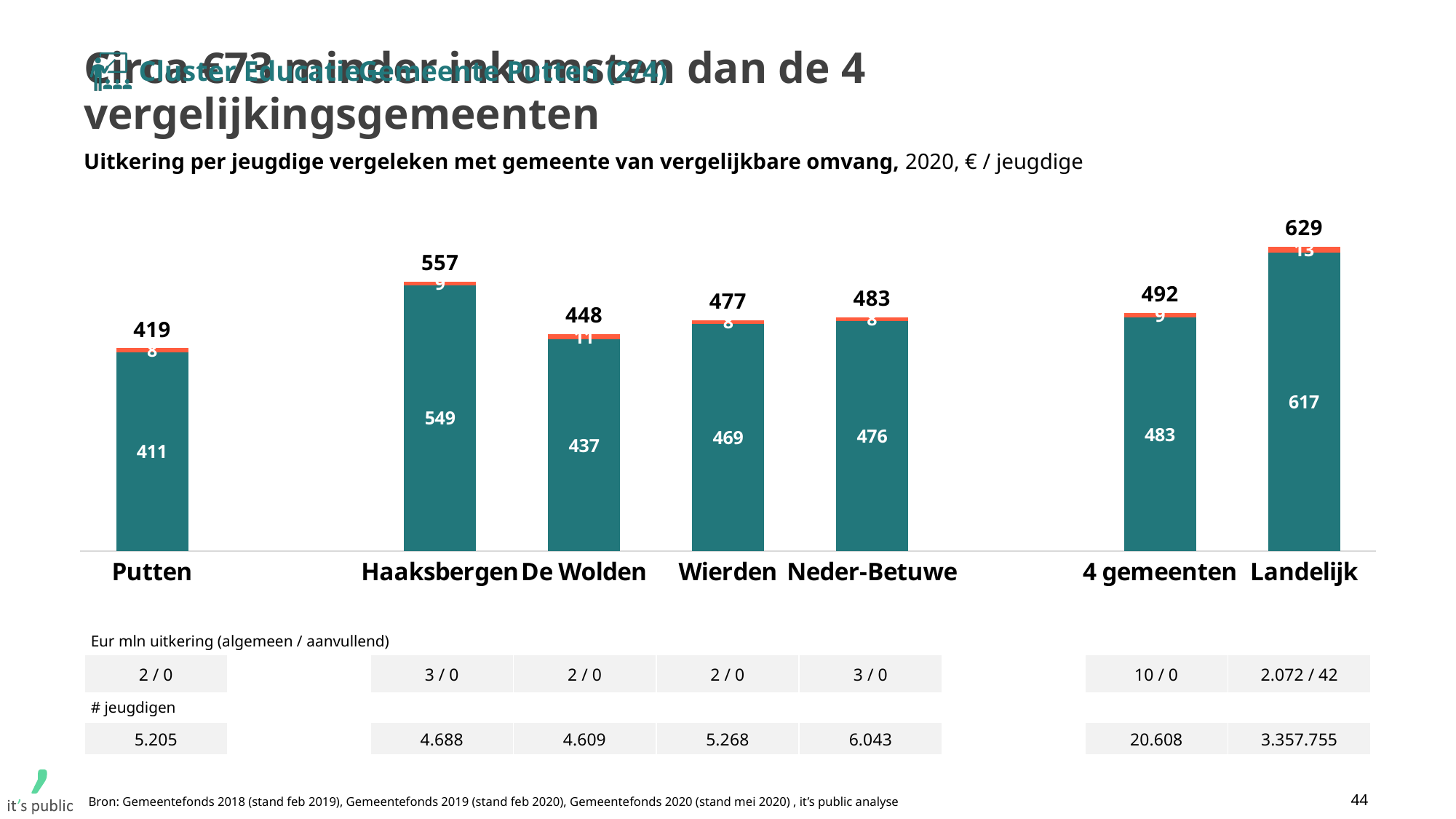
What is the value of the large teal segment of the 4 gemeenten bar? 483 Which has a higher total value, Wierden or Neder-Betuwe? Neder-Betuwe What is the total value shown above the bar for De Wolden? 448 What is the difference between the total for Landelijk and the total for Haaksbergen? 72 What is the total value shown above the bar for Landelijk? 629 What kind of chart is shown on the slide? Stacked bar chart Which category has the lowest total value? Putten What is the total value shown above the bar for Putten? 419 What is the value of the large teal segment of the Haaksbergen bar? 549 How many categories are shown on the x axis of the chart? 7 Which category has the highest total value? Landelijk What is the difference between the total for 4 gemeenten and the total for Putten? 73